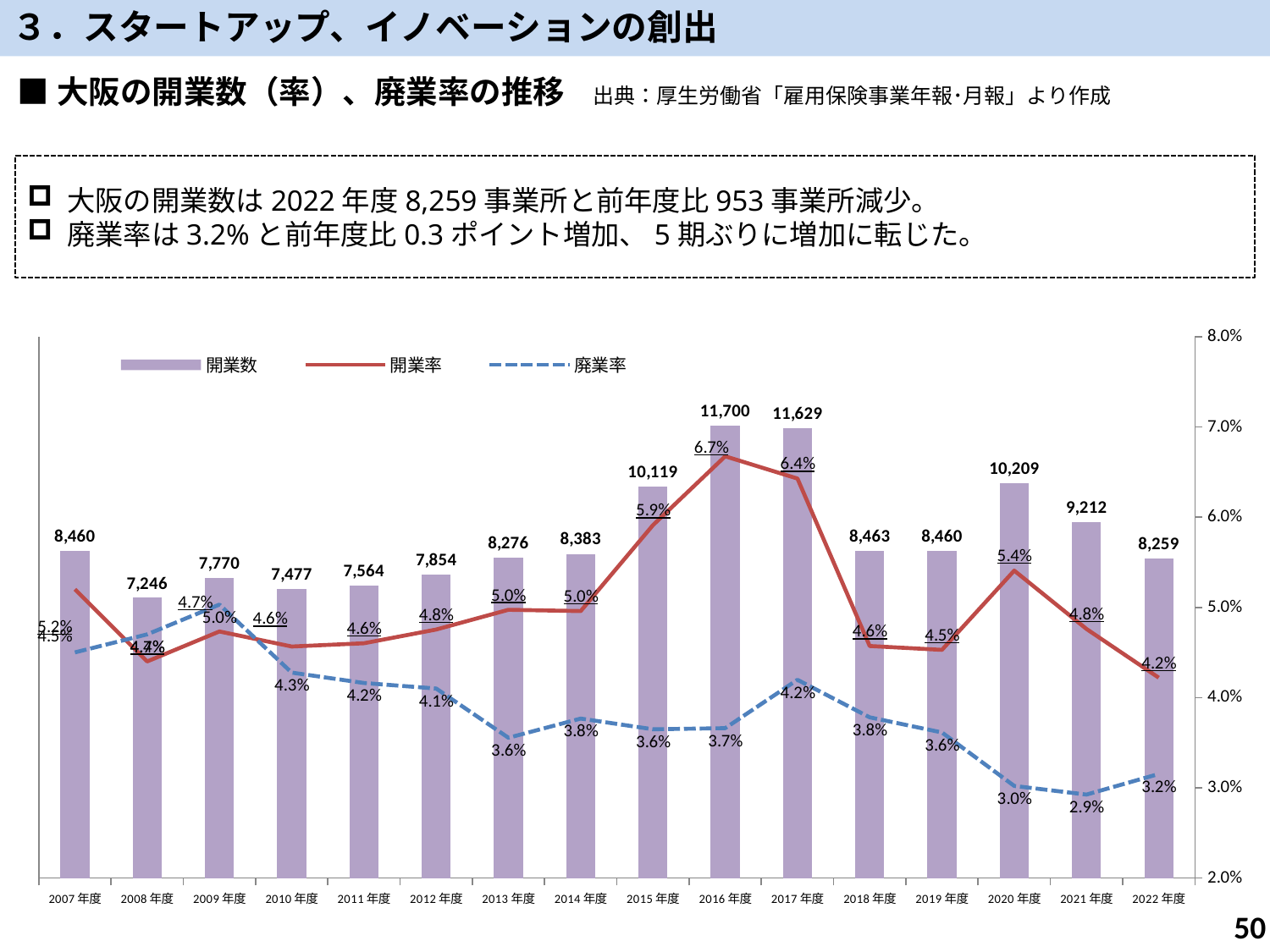
Which is larger, the 開業数 for 2015年度 or for 2020年度? 2020年度 Does the 廃業率 rise or fall from 2017年度 to 2021年度? Fall How many series does the legend list? 3 What kind of chart is this? Combined bar and line chart Which year has the lowest 開業数? 2008年度 How many years are shown on the x axis? 16 Which year has the highest 開業数? 2016年度 What is the value of 開業数 for 2022年度? 8,259 What is the 廃業率 for 2022年度? 3.2% Which year has the lowest 廃業率? 2021年度 What is the 開業率 for 2016年度? 6.7% What is the difference in 開業数 between 2021年度 and 2022年度? 953